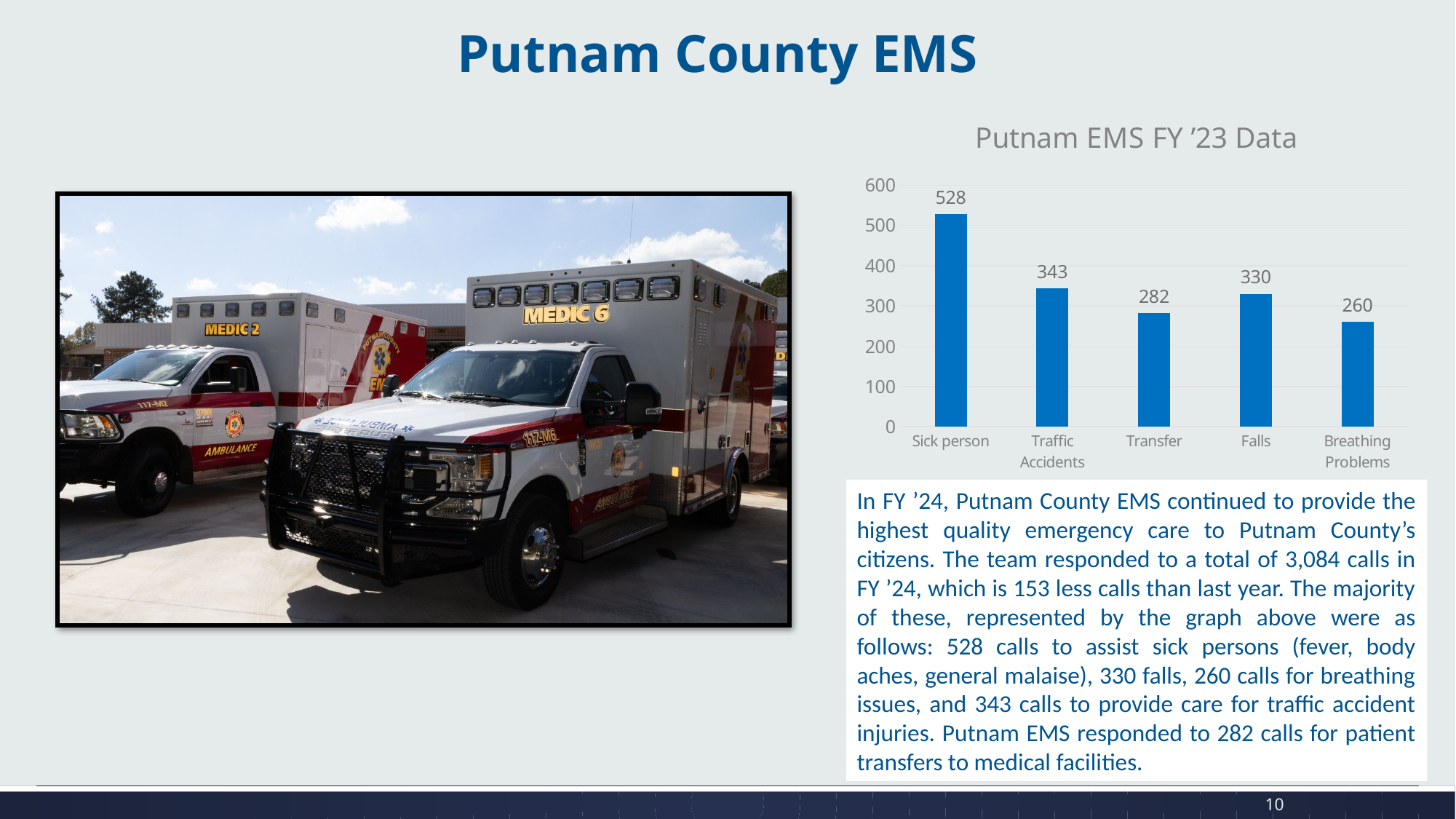
Is the value for Transfer greater or less than 300? less What kind of chart is shown on the slide? bar chart What is the title of the chart? Putnam EMS FY '23 Data What is the difference between the values for Traffic Accidents and Transfer? 61 Which category has the highest value in the chart? Sick person What is the value for Traffic Accidents in the chart? 343 Which category has the lowest value in the chart? Breathing Problems What is the value for Breathing Problems in the chart? 260 What is the value for Sick person in the chart? 528 How many categories are shown in the chart? 5 Which is larger, the value for Falls or the value for Transfer? Falls What is the difference between the values for Sick person and Falls? 198